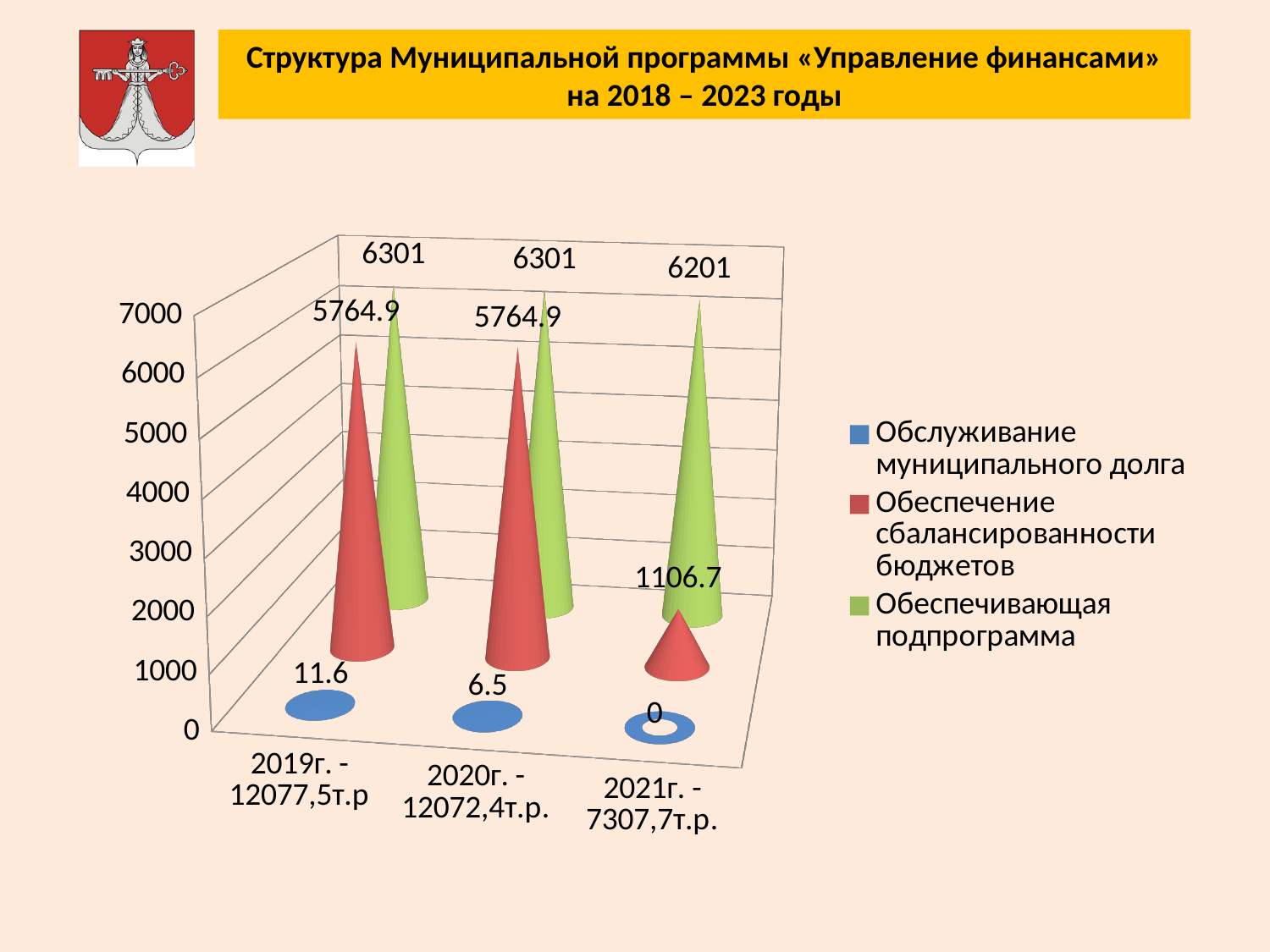
What is the value of «Обеспечение сбалансированности бюджетов» for 2019г.? 5764.9 Does the value of «Обеспечение сбалансированности бюджетов» rise or fall from 2020г. to 2021г.? fall Which is larger in 2021г.: «Обеспечивающая подпрограмма» or «Обеспечение сбалансированности бюджетов»? Обеспечивающая подпрограмма How many year categories are shown on the x axis? 3 What is the value of «Обеспечение сбалансированности бюджетов» for 2021г.? 1106.7 What is the difference between the «Обеспечивающая подпрограмма» values for 2019г. and 2021г.? 100 What kind of chart is shown on the slide? bar chart What is the value of «Обеспечивающая подпрограмма» for 2021г.? 6201 What is the value of «Обслуживание муниципального долга» for 2020г.? 6.5 In which year is the value of «Обслуживание муниципального долга» the lowest? 2021г. In which year is the value of «Обеспечение сбалансированности бюджетов» the lowest? 2021г. How many series does the legend list? 3